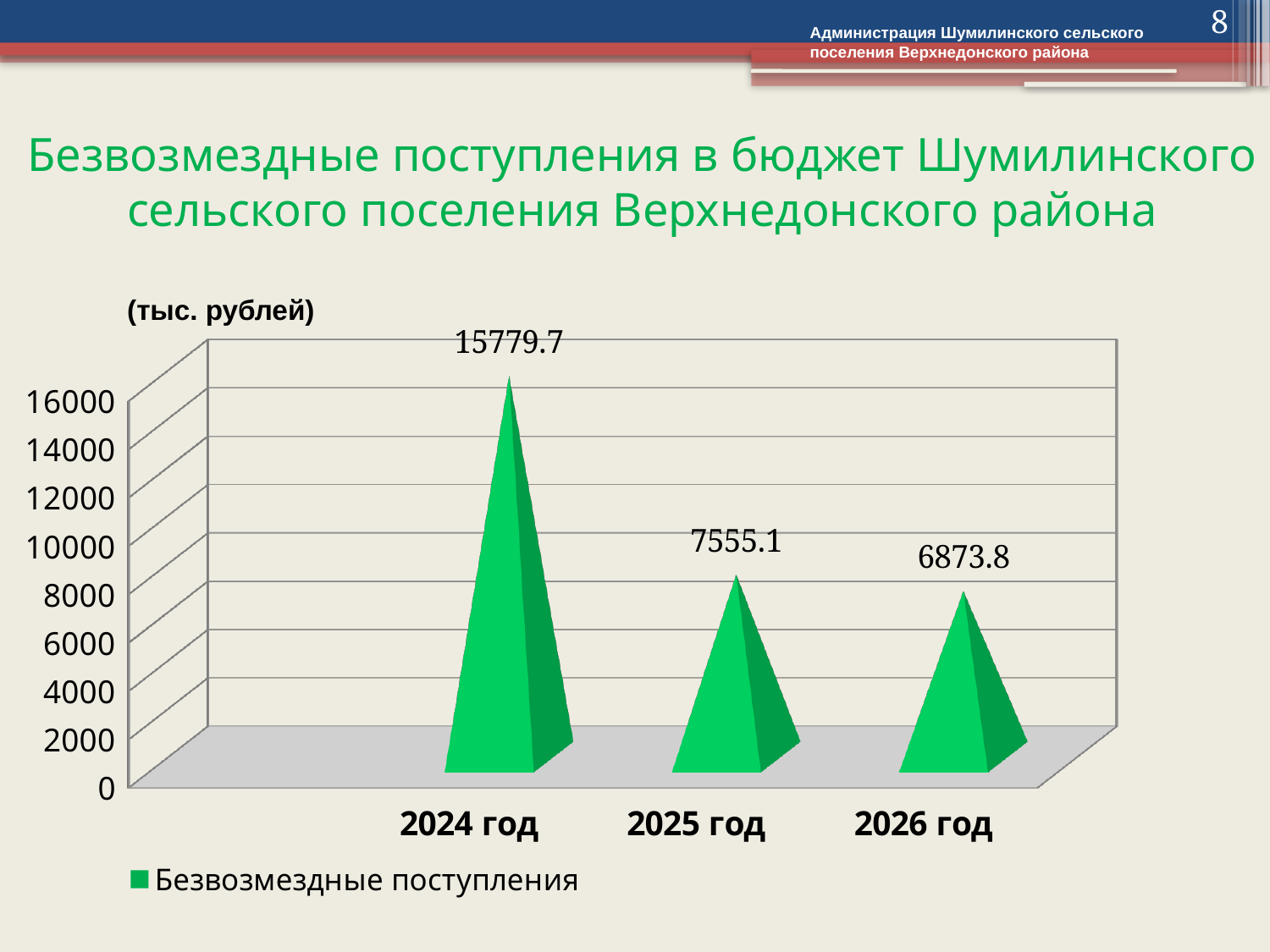
What is the value for 2024 год? 15779.7 What is the difference between the values for 2025 год and 2026 год? 681.3 Which year has the highest value? 2024 год Is the value for 2024 год greater or less than 14000? greater Which is larger, the value for 2025 год or the value for 2026 год? 2025 год What is the value for 2026 год? 6873.8 How many years are shown on the x axis? 3 What is the difference between the values for 2024 год and 2025 год? 8224.6 What is the value for 2025 год? 7555.1 Do the values rise or fall from 2024 год to 2026 год? fall What series name does the legend show? Безвозмездные поступления Which year has the lowest value? 2026 год